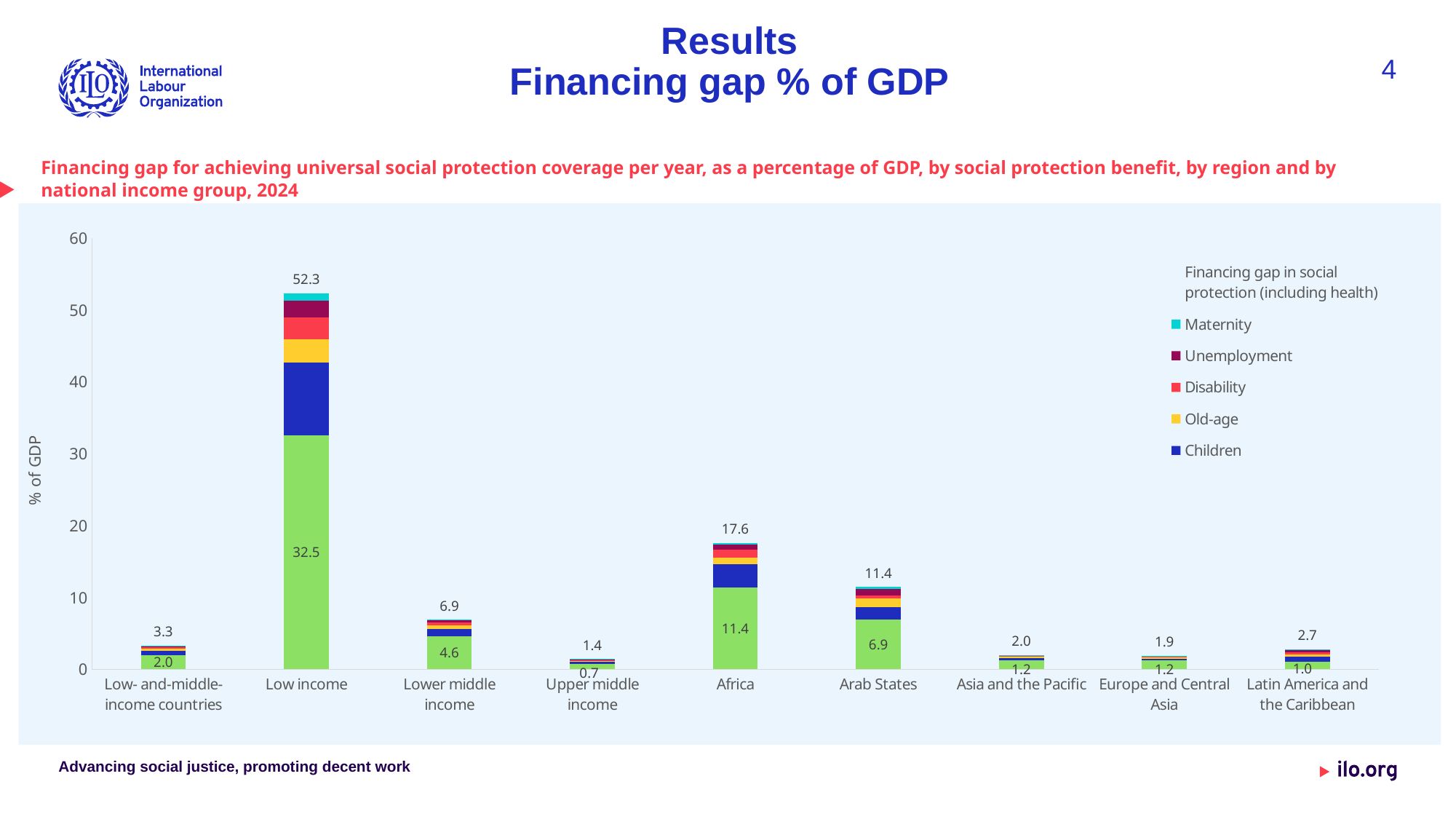
How many categories are shown on the x axis? 9 What value is printed on the green segment of the Low income bar? 32.5 What is the total financing gap (% of GDP) shown for Low income? 52.3 Which category has the lowest total financing gap? Upper middle income What is the difference between the total financing gap for Africa and for Arab States? 6.2 Is the total value for Low income greater or less than 50? greater What is the label on the y axis? % of GDP How many entries does the legend list? 5 What is the total financing gap shown for Latin America and the Caribbean? 2.7 What kind of chart is shown on the slide? Stacked bar chart Which category has the highest total financing gap? Low income Which has a larger total financing gap: Asia and the Pacific or Europe and Central Asia? Asia and the Pacific